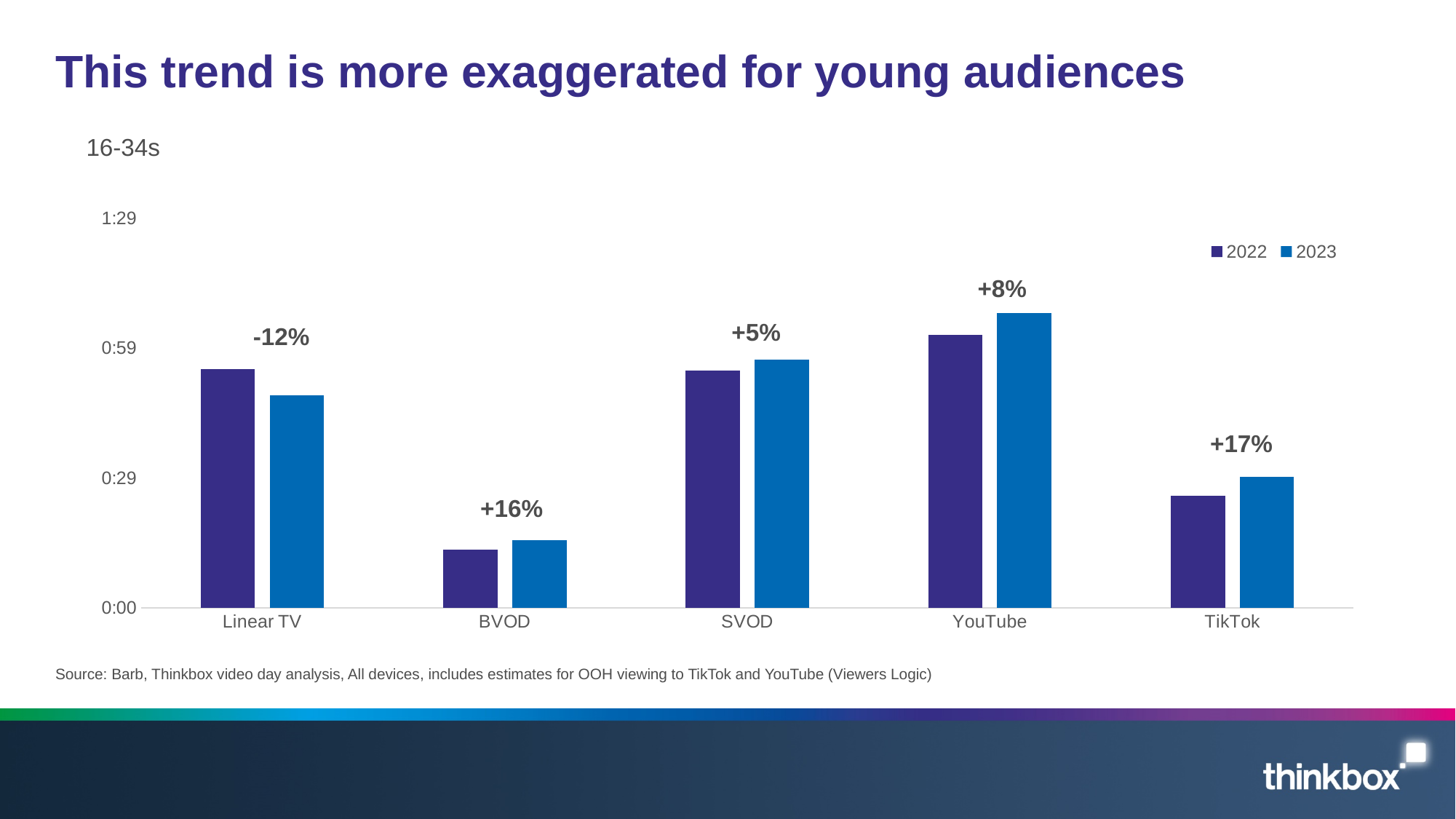
Which category has the lowest 2022 bar? BVOD What percentage change is printed above the TikTok bars? +17% Which category shows the largest printed percentage increase? TikTok For Linear TV, which is larger: the 2022 bar or the 2023 bar? 2022 Which category has the highest 2023 bar? YouTube What percentage change is printed above the Linear TV bars? -12% What percentage change is printed above the SVOD bars? +5% Is the 2023 value for YouTube greater or less than 0:59? greater Is the 2022 value for BVOD greater or less than 0:29? less How many categories are shown on the x axis of the chart? 5 How many series does the chart's legend list? 2 What kind of chart is shown on the slide? Bar chart